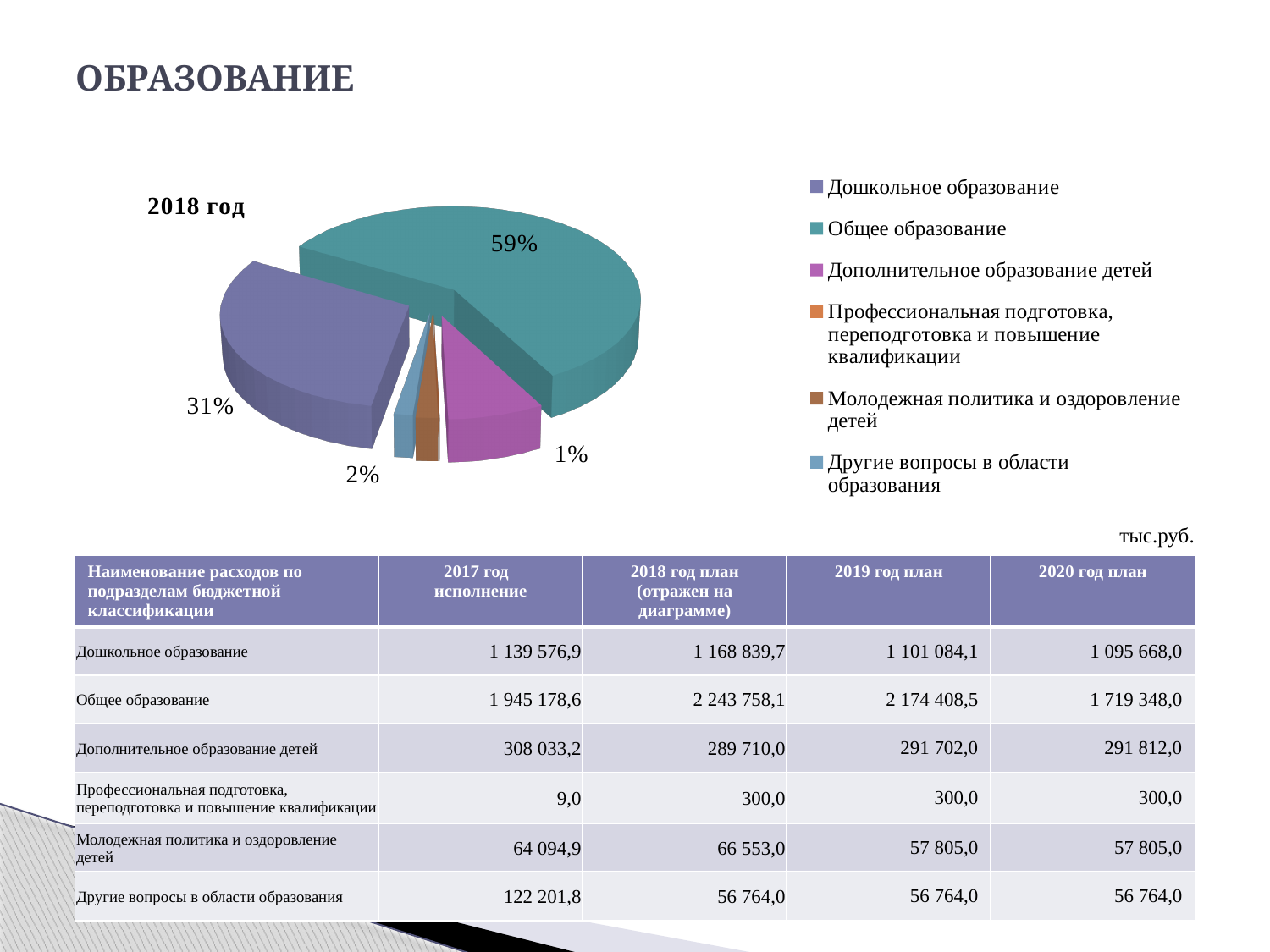
What is the smallest percentage label shown on the pie chart? 1% What share of the pie does Дошкольное образование have? 31% What is the title of the pie chart? 2018 год What share of the pie does Общее образование have? 59% Which slice is larger: Общее образование or Дошкольное образование? Общее образование By how many percentage points does the Общее образование slice exceed the Дошкольное образование slice? 28 What colour is the Общее образование slice in the pie chart? Teal Which category has the largest slice of the pie chart? Общее образование What kind of chart is shown on the slide? Pie chart How many slices does the pie chart have? 6 How many entries does the legend of the pie chart list? 6